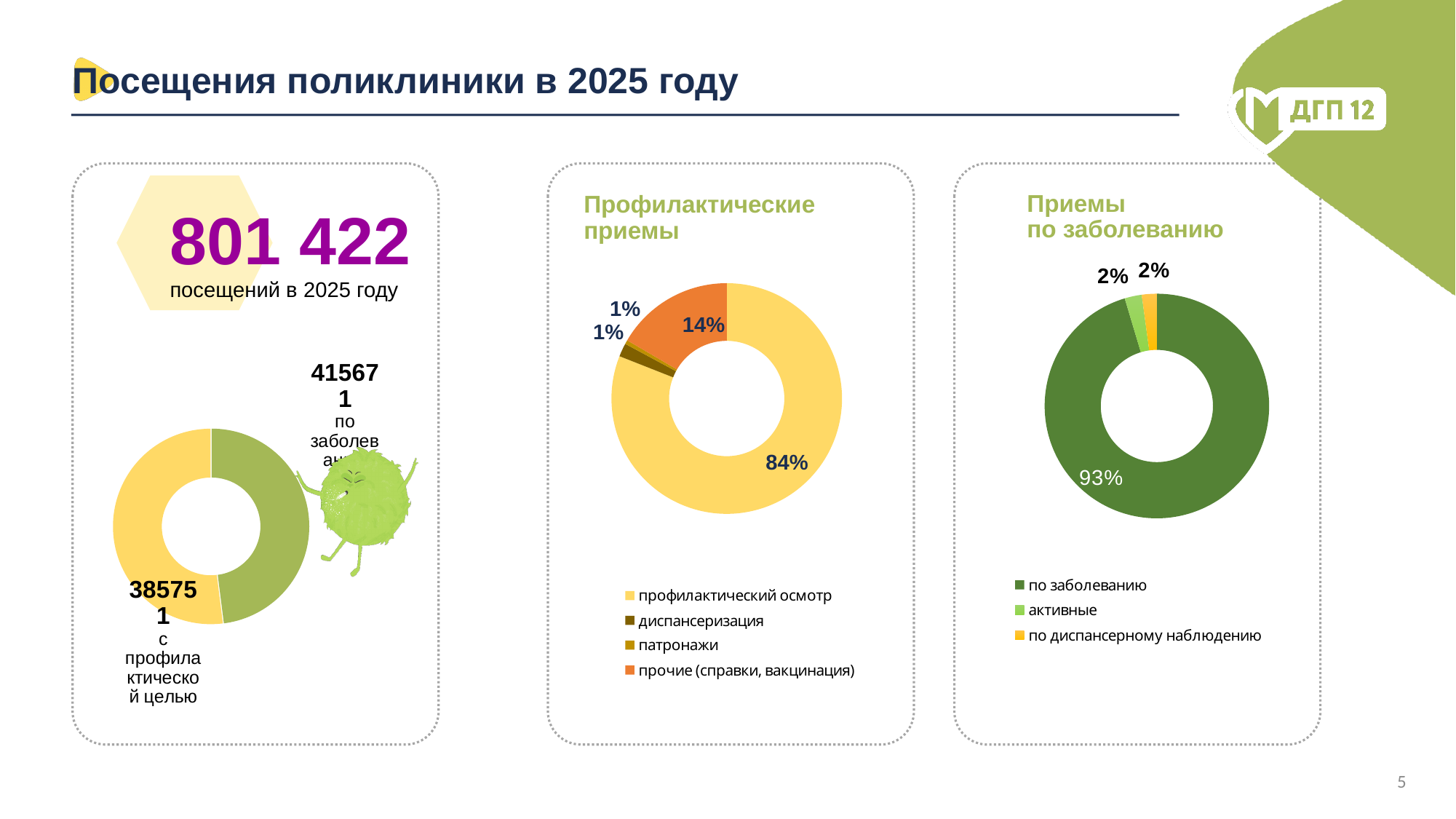
In the 'Профилактические приемы' chart, which category has the largest share? профилактический осмотр In the left chart, what is the value for visits с профилактической целью? 385751 In the left chart, what is the value for visits по заболеванию? 415671 In the left chart, which category has the larger value: по заболеванию or с профилактической целью? по заболеванию In the 'Профилактические приемы' chart, what share is прочие (справки, вакцинация)? 14% What kind of chart is the 'Приемы по заболеванию' chart? donut chart In the 'Профилактические приемы' chart, what share is профилактический осмотр? 84% How many categories does the legend of the 'Приемы по заболеванию' chart list? 3 How many categories does the legend of the 'Профилактические приемы' chart list? 4 In the 'Приемы по заболеванию' chart, what share is по заболеванию? 93% In the 'Приемы по заболеванию' chart, what share is активные? 2% In the left chart, what is the difference between the visits по заболеванию and the visits с профилактической целью? 29920